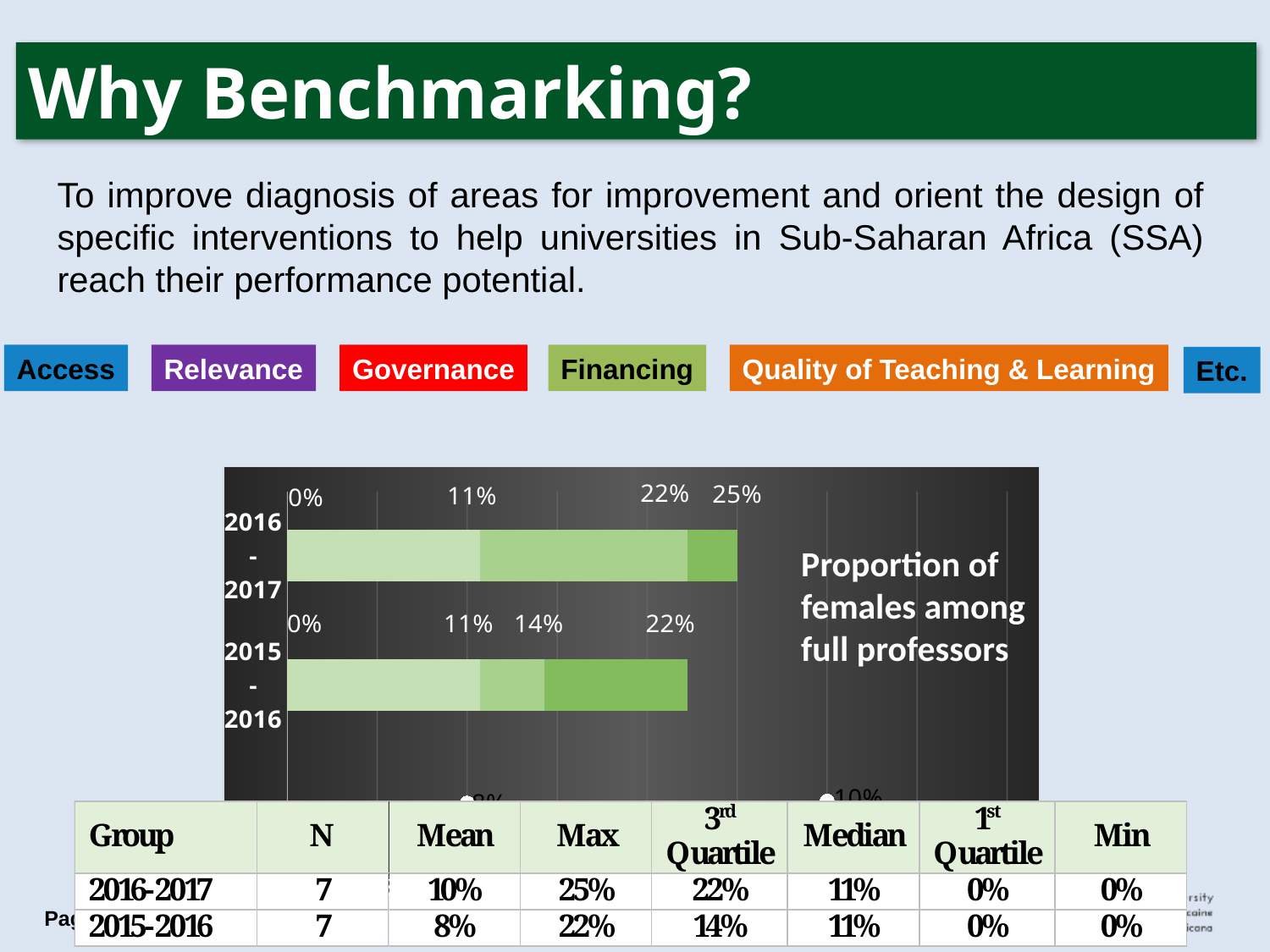
What is the smallest value label shown for the 2015-2016 bar? 0% Which period has the higher maximum value in the chart, 2016-2017 or 2015-2016? 2016-2017 What is the third value label (from left) shown above the 2015-2016 bar? 14% What is the title of the chart on the slide? Proportion of females among full professors How many periods (categories) are plotted in the chart? 2 What is the largest value label shown for the 2015-2016 bar? 22% What is the difference between the maximum value for 2016-2017 (25%) and the maximum value for 2015-2016 (22%)? 3% What is the largest value label shown for the 2016-2017 bar? 25% Which period's bar extends further to the right in the chart? 2016-2017 What is the difference between the 22% and 14% labels shown for the 2015-2016 bar? 8% What is the third value label (from left) shown above the 2016-2017 bar? 22% What kind of chart is shown on the slide? bar chart